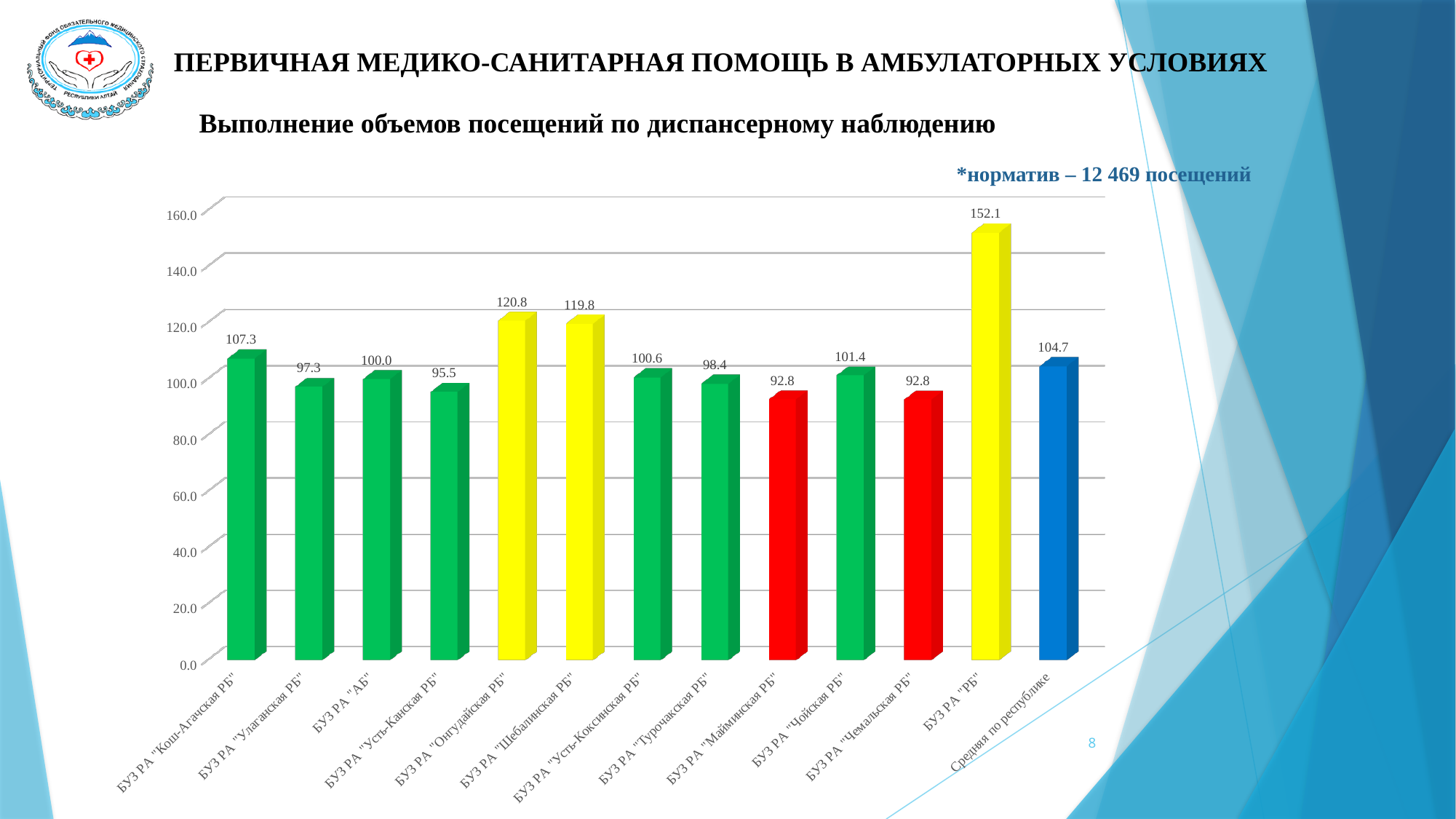
Which category has the highest value? БУЗ РА "РБ" How many bars are shown on the chart? 13 What is the value for БУЗ РА "Онгудайская РБ"? 120.8 What is the value for БУЗ РА "Кош-Агачская РБ"? 107.3 Is the value for БУЗ РА "Шебалинская РБ" greater or less than 100.0? greater What is the value for БУЗ РА "Чойская РБ"? 101.4 Which is larger, the value for БУЗ РА "Улаганская РБ" or БУЗ РА "Усть-Канская РБ"? БУЗ РА "Улаганская РБ" What colour is the bar for Средняя по республике? blue What is the value for Средняя по республике? 104.7 What is the difference between the values for БУЗ РА "РБ" and БУЗ РА "Онгудайская РБ"? 31.3 What is the lowest value shown on the chart? 92.8 What type of chart is shown on the slide? bar chart